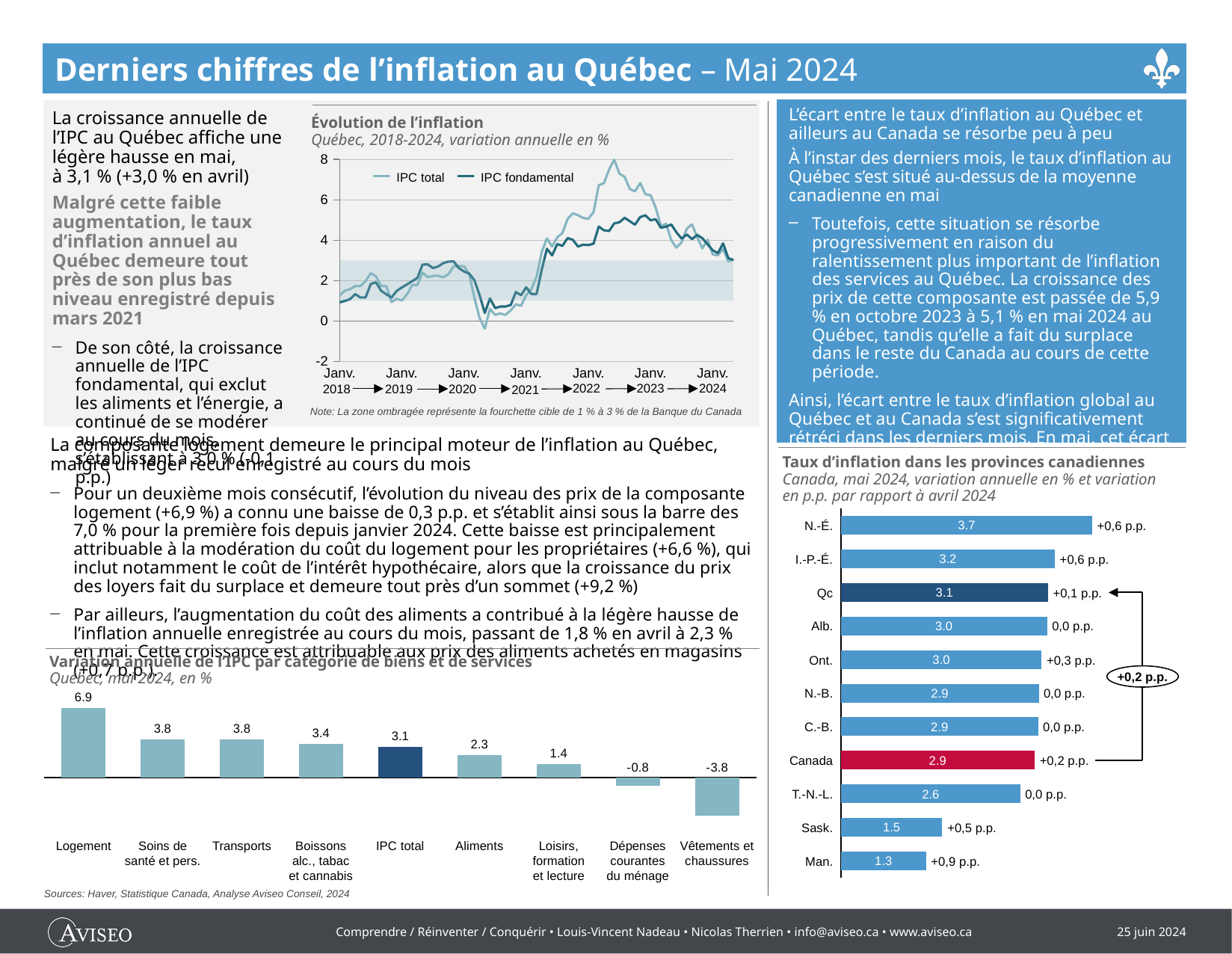
In the chart 'Variation annuelle de l'IPC par catégorie de biens et de services', what is the difference between Logement and IPC total? 3.8 In the chart 'Variation annuelle de l'IPC par catégorie de biens et de services', which category has the lowest value? Vêtements et chaussures In the chart 'Taux d'inflation dans les provinces canadiennes', which province has the highest inflation rate? N.-É. In the chart 'Évolution de l'inflation', how many series does the legend list? 2 In the chart 'Évolution de l'inflation', what kind of chart is it? Line chart In the chart 'Taux d'inflation dans les provinces canadiennes', what is the inflation rate for Man.? 1.3 In the chart 'Taux d'inflation dans les provinces canadiennes', what is the change in p.p. shown next to Qc? +0,1 p.p. In the chart 'Variation annuelle de l'IPC par catégorie de biens et de services', which is larger: Aliments or Loisirs, formation et lecture? Aliments In the chart 'Taux d'inflation dans les provinces canadiennes', what is the difference between the rates for N.-É. and Canada? 0.8 In the chart 'Variation annuelle de l'IPC par catégorie de biens et de services', how many categories are shown? 9 In the chart 'Variation annuelle de l'IPC par catégorie de biens et de services', what is the value for Logement? 6.9 In the chart 'Taux d'inflation dans les provinces canadiennes', how many bars are shown? 11